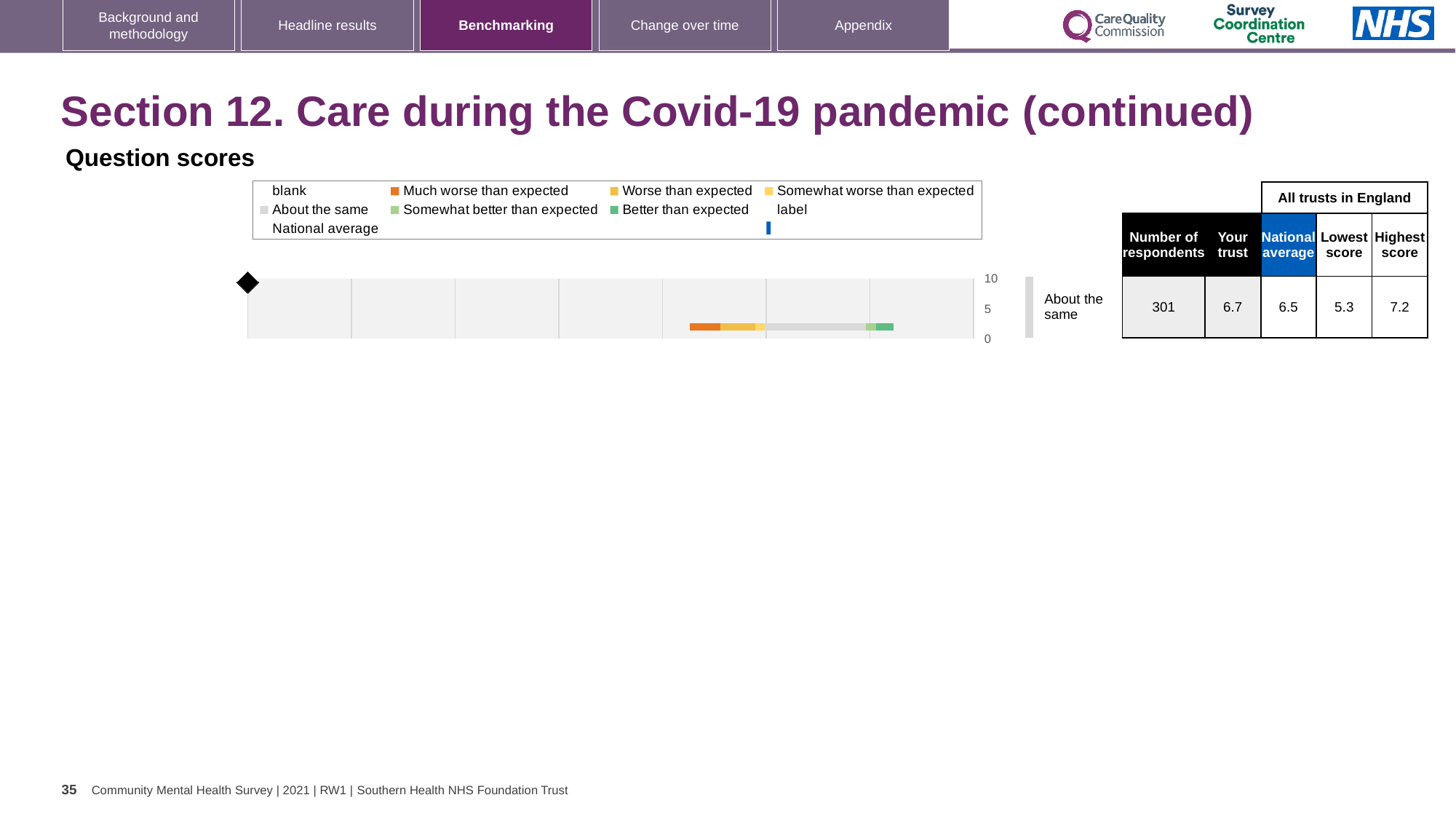
In the table beside the chart, what is the highest score among all trusts in England? 7.2 In the table beside the chart, what is the lowest score among all trusts in England? 5.3 What kind of chart is shown under 'Question scores'? bar chart Which is larger, the 'Your trust' score or the national average? Your trust What is the highest value shown on the chart's numeric axis? 10 In the table beside the chart, what is the number of respondents? 301 What category label is shown next to the bar in the chart? About the same In the table beside the chart, what is the score for 'Your trust'? 6.7 What is the difference between the highest score and the lowest score in the table? 1.9 In the table beside the chart, what is the national average score? 6.5 How many bars are plotted in the chart? 1 How many entries does the chart legend list? 9